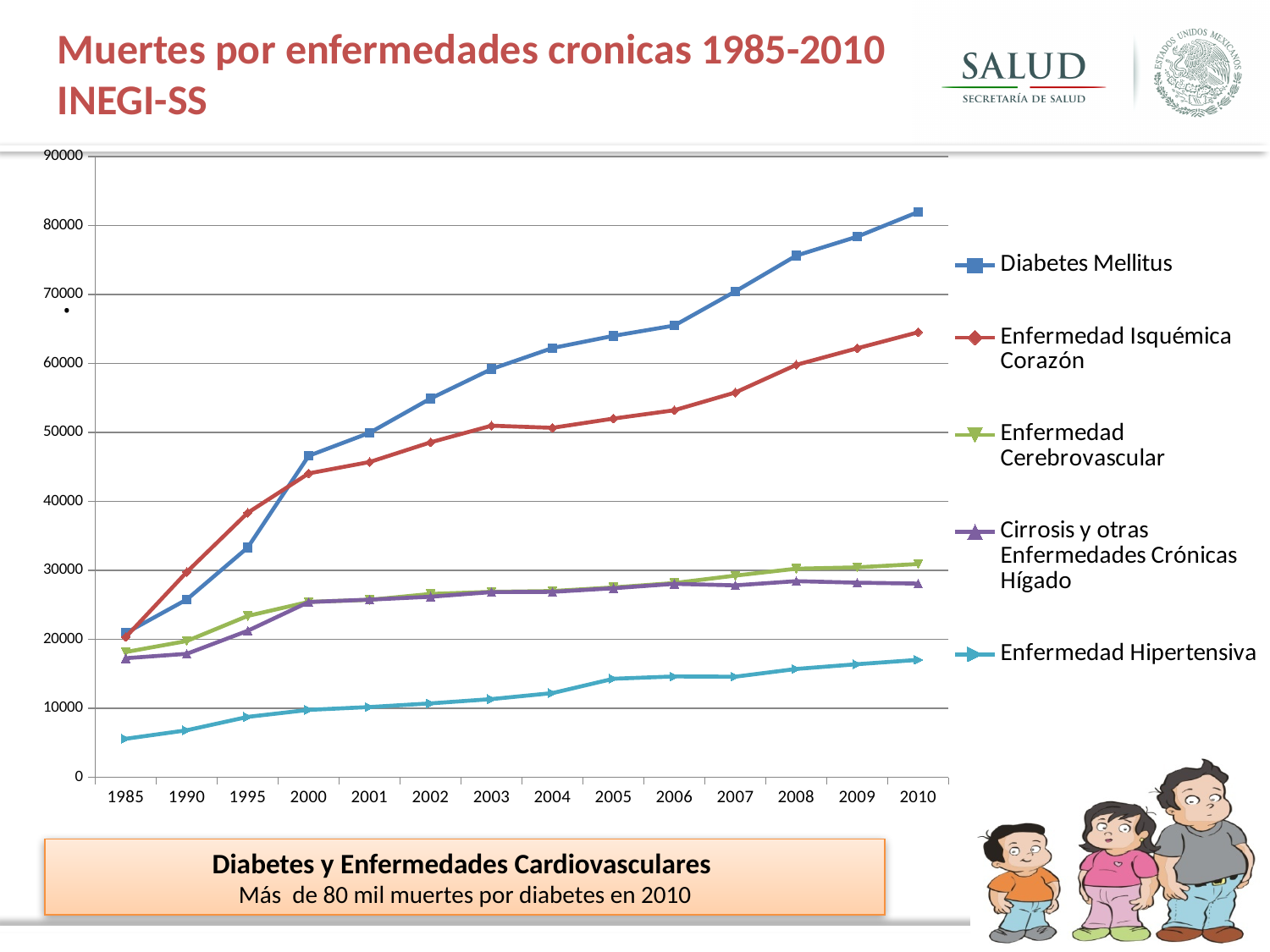
Which series has the lowest value in 2010? Enfermedad Hipertensiva Do the values for Diabetes Mellitus rise or fall from 1985 to 2010? rise Is the value for Enfermedad Hipertensiva in 1985 greater or less than 10000? less Is the value for Cirrosis y otras Enfermedades Crónicas Hígado in 2010 greater or less than 30000? less In 1995, which is larger: Diabetes Mellitus or Enfermedad Isquémica Corazón? Enfermedad Isquémica Corazón What kind of chart is shown on the slide? line chart What colour is the line for Diabetes Mellitus? blue Is the value for Enfermedad Isquémica Corazón in 2010 greater or less than 60000? greater Which series has the highest value in 2010? Diabetes Mellitus How many series does the legend list? 5 How many years are shown along the x axis? 14